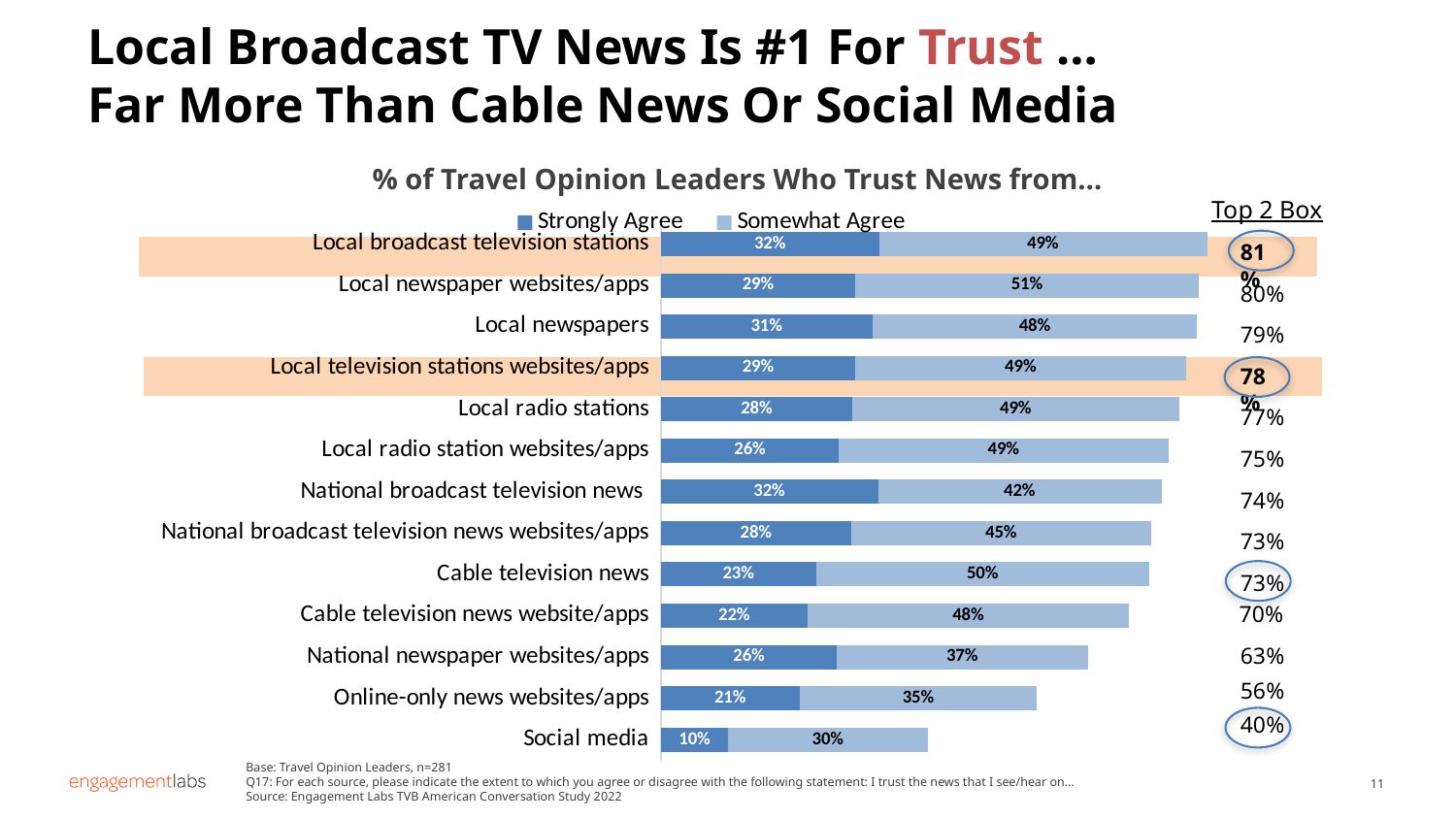
Which has a larger Somewhat Agree value: National newspaper websites/apps or Online-only news websites/apps? National newspaper websites/apps How many series does the legend list? 2 What is the Strongly Agree value for Cable television news? 23% What type of chart is shown on the slide? Stacked bar chart What percentage of Travel Opinion Leaders strongly agree that they trust news from Social media? 10% How many news sources are shown in the chart? 13 What is the total (Strongly Agree plus Somewhat Agree) for Local radio stations? 77% What is the title of the chart? % of Travel Opinion Leaders Who Trust News from… What is the difference between the Strongly Agree values for Local broadcast television stations and Social media? 22% Which source has the highest Somewhat Agree percentage? Local newspaper websites/apps What is the Somewhat Agree value for Local newspaper websites/apps? 51% Which source has the lowest Strongly Agree percentage? Social media